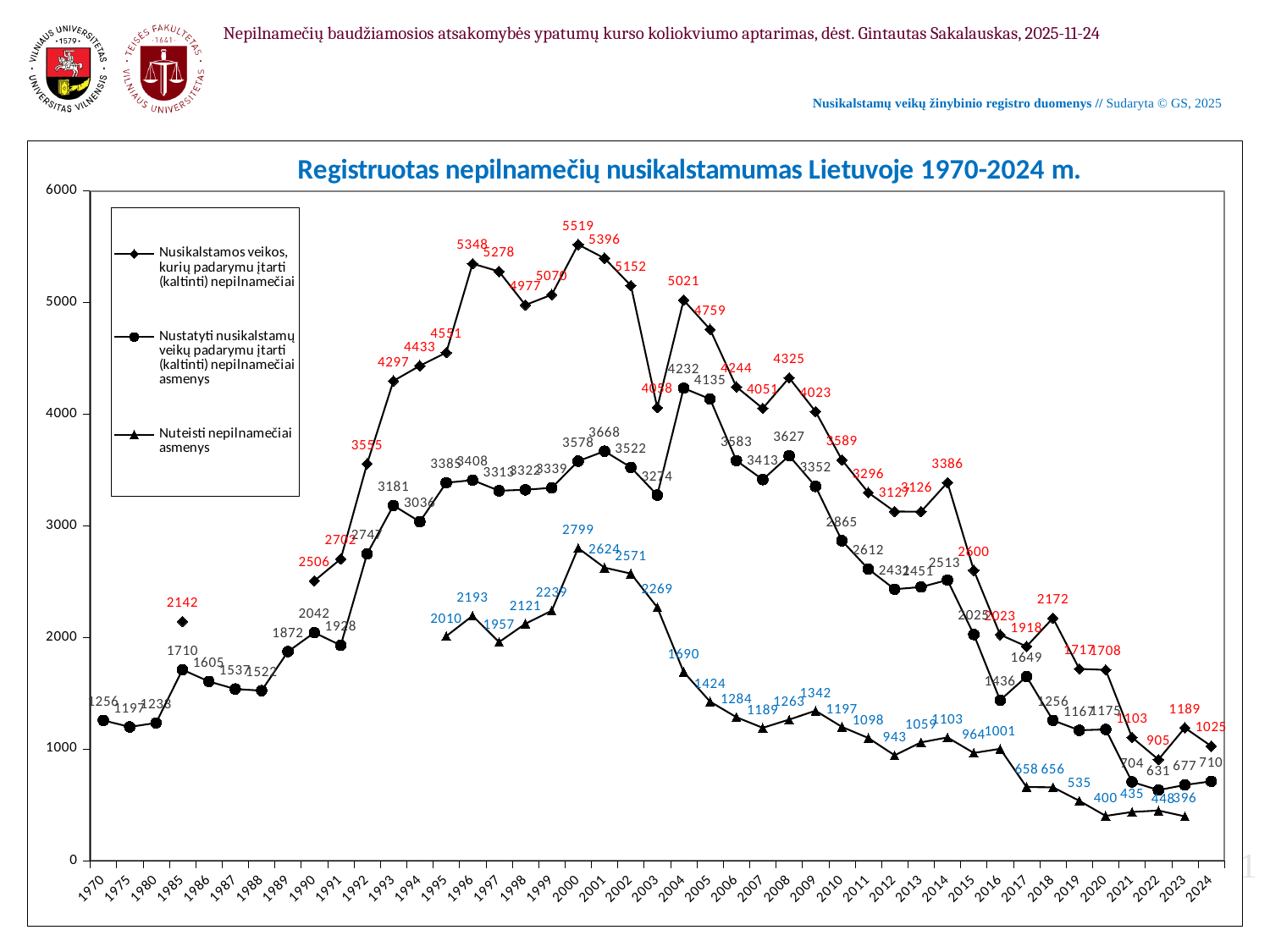
In which year does the 'Nusikalstamos veikos, kurių padarymu įtarti (kaltinti) nepilnamečiai' series reach its highest value? 2000 What is the value of 'Nusikalstamos veikos, kurių padarymu įtarti (kaltinti) nepilnamečiai' in 2000? 5519 How many series does the legend list? 3 What is the difference between 'Nusikalstamos veikos, kurių padarymu įtarti (kaltinti) nepilnamečiai' and 'Nustatyti nusikalstamų veikų padarymu įtarti (kaltinti) nepilnamečiai asmenys' in 2000? 1941 In which year does the 'Nustatyti nusikalstamų veikų padarymu įtarti (kaltinti) nepilnamečiai asmenys' series reach its lowest value? 2022 What is the value of 'Nustatyti nusikalstamų veikų padarymu įtarti (kaltinti) nepilnamečiai asmenys' in 1970? 1256 What is the title of the chart? Registruotas nepilnamečių nusikalstamumas Lietuvoje 1970-2024 m. Does the 'Nusikalstamos veikos, kurių padarymu įtarti (kaltinti) nepilnamečiai' series rise or fall from 2014 to 2017? Fall What type of chart is shown on the slide? Line chart Which year has the larger value for 'Nusikalstamos veikos, kurių padarymu įtarti (kaltinti) nepilnamečiai': 2003 or 2004? 2004 What is the highest value of the 'Nuteisti nepilnamečiai asmenys' series? 2799 What is the value of 'Nuteisti nepilnamečiai asmenys' in 2023? 396